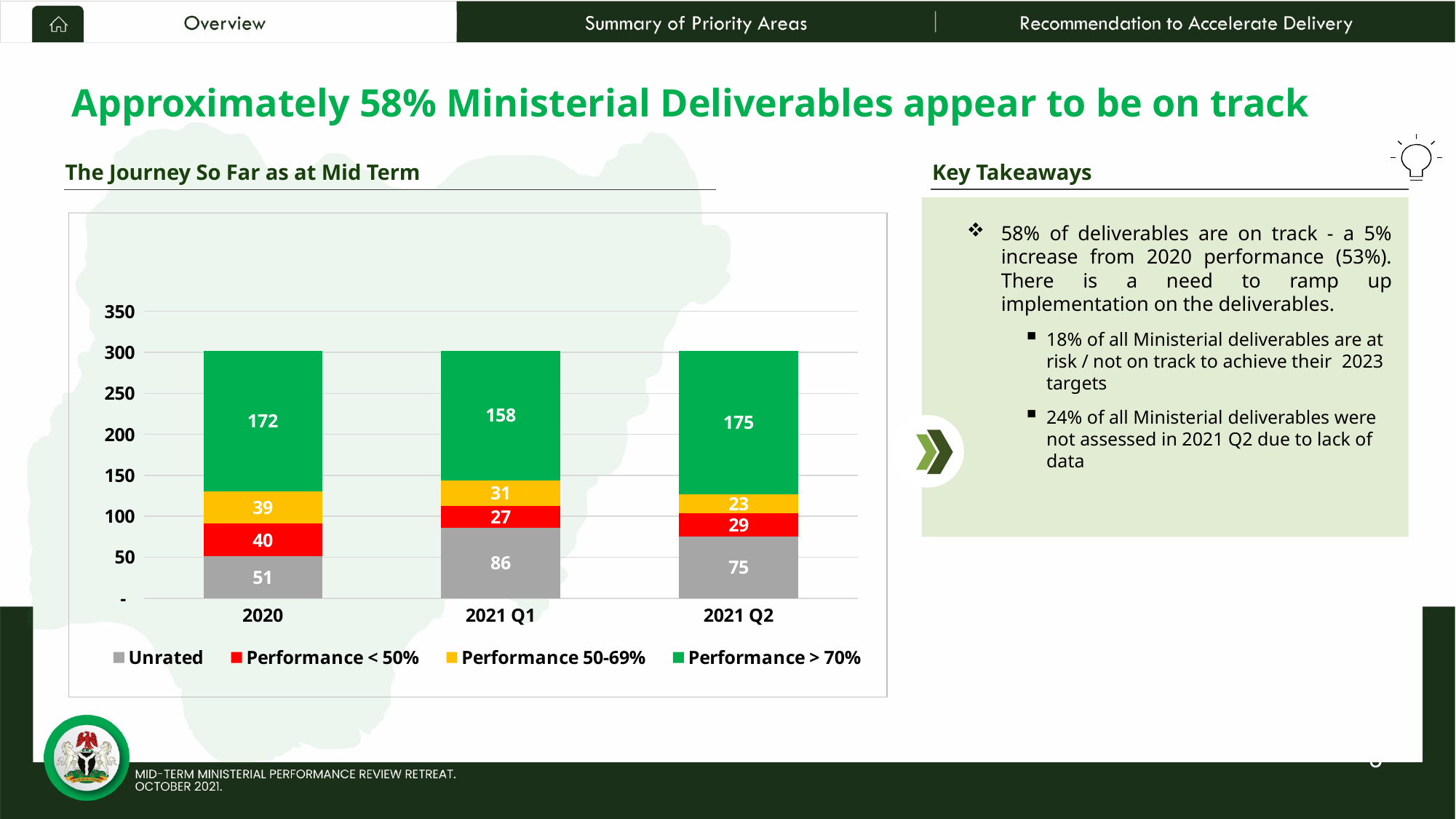
Which period has the highest Performance > 70% value? 2021 Q2 How many categories are shown on the x axis? 3 What is the total of the stacked bar for 2021 Q1? 302 What type of chart is shown on the slide? Stacked bar chart What is the title of the chart section on the slide? The Journey So Far as at Mid Term What is the Unrated value for 2021 Q1? 86 How many series does the legend list? 4 What is the Performance > 70% value for 2021 Q2? 175 What is the difference between the Performance > 70% values for 2020 and 2021 Q1? 14 What is the Performance 50-69% value for 2020? 39 Which is larger, the Performance < 50% value for 2020 or for 2021 Q2? 2020 Which period has the lowest Unrated value? 2020